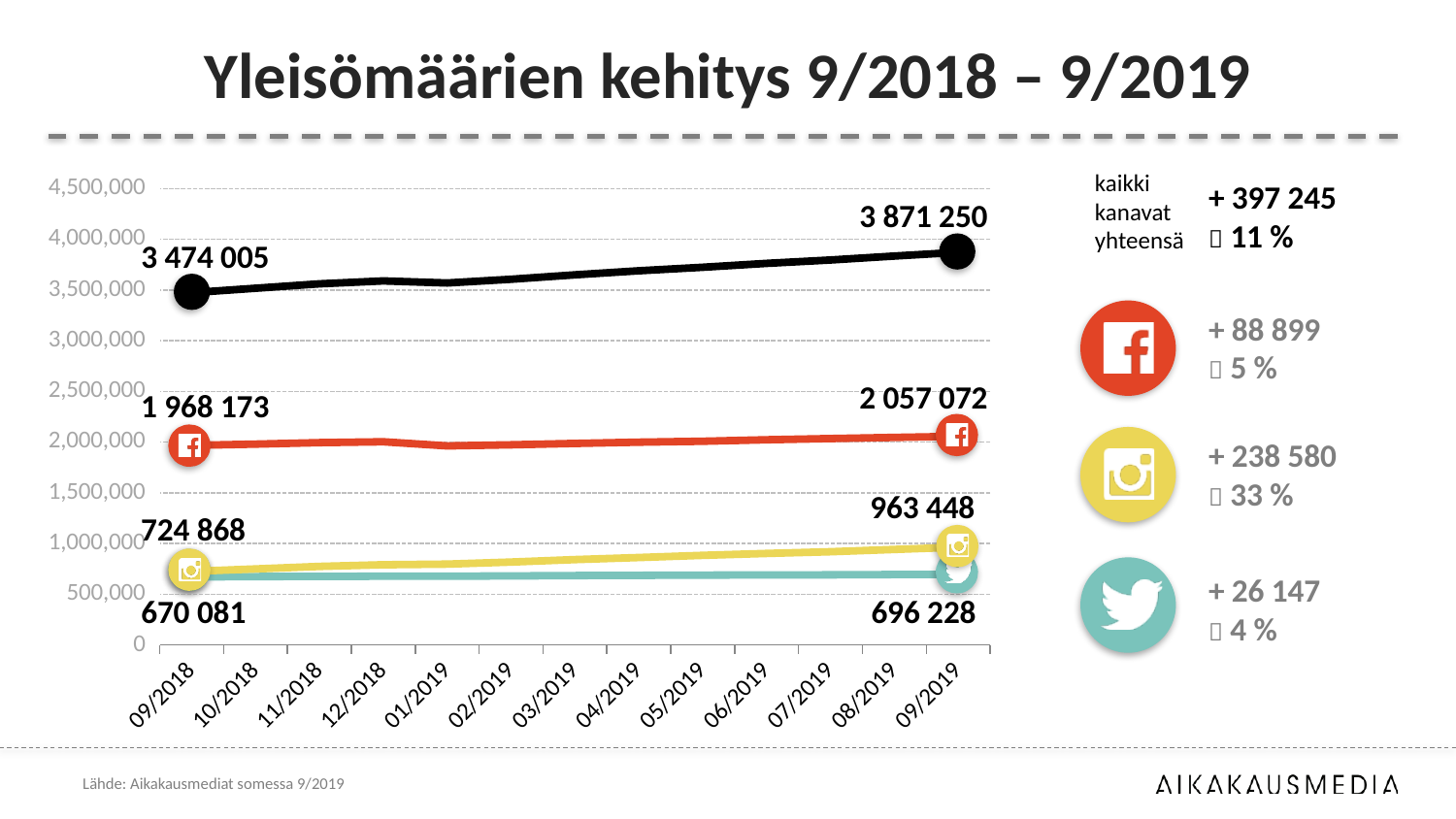
What is the value of the black (total) line at 09/2018? 3 474 005 What is the value of the black (total) line at 09/2019? 3 871 250 By how much did the Instagram (yellow) line increase from 09/2018 to 09/2019? 238 580 Which line has the lowest value at 09/2019? Twitter (teal) At 09/2019, which is larger: the Instagram (yellow) value or the Twitter (teal) value? Instagram (yellow) What kind of chart is shown on the slide? line chart By how much did the Facebook (red) line increase from 09/2018 to 09/2019? 88 899 What is the Instagram (yellow) line's value at 09/2018? 724 868 Does the black (total) line rise or fall from 09/2018 to 09/2019? rise What is the Facebook (red) line's value at 09/2019? 2 057 072 What is the Twitter (teal) line's value at 09/2019? 696 228 How many months are shown on the x axis? 13